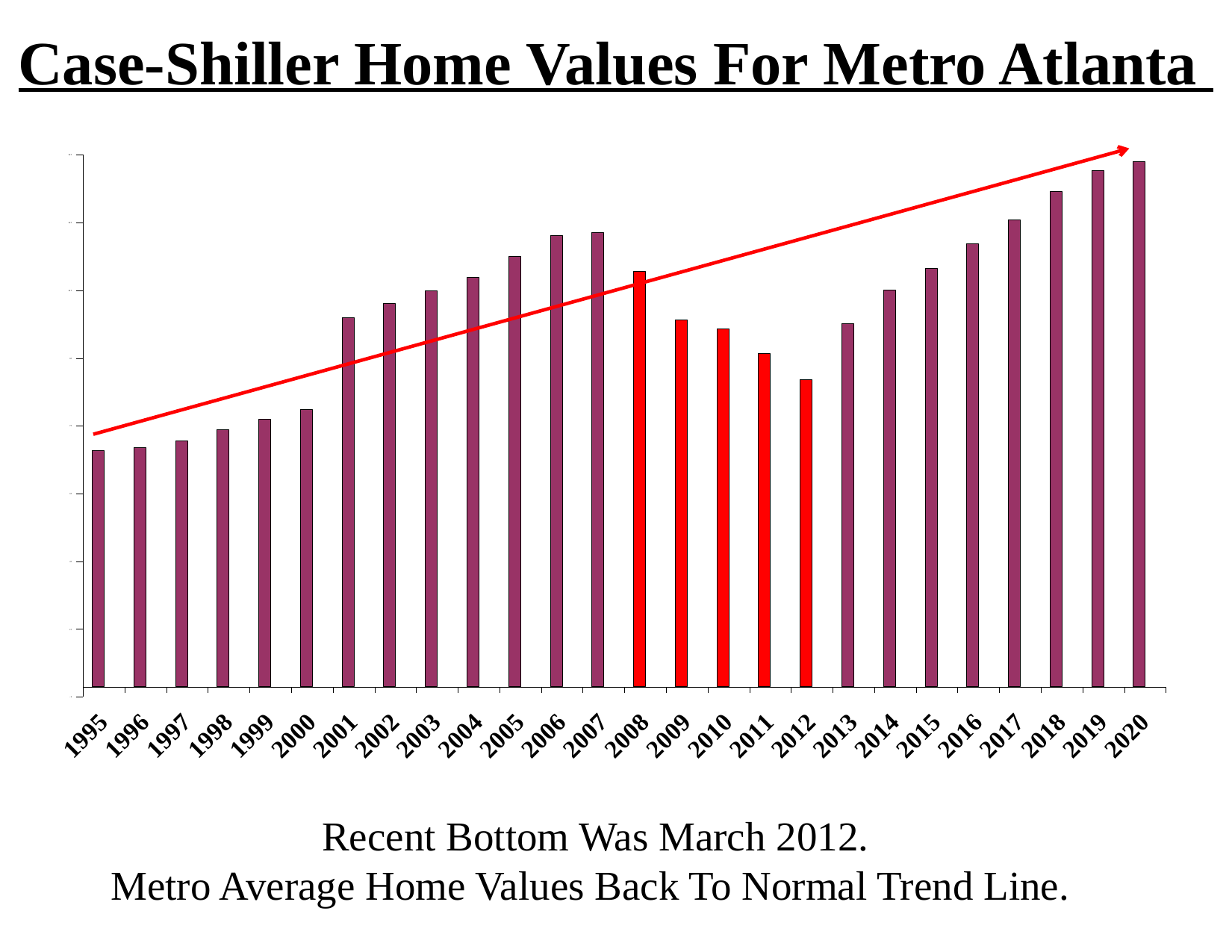
Which year has the higher value, 2007 or 2012? 2007 Which year has the highest home value on the chart? 2020 How many years (bars) are plotted on the chart? 26 What is the title of the chart on the slide? Case-Shiller Home Values For Metro Atlanta Which year has the higher value, 2000 or 2001? 2001 Do the values rise or fall from 2008 to 2012? Fall Which year has the higher value, 2006 or 2019? 2019 Which years are shown with bright red bars? 2008, 2009, 2010, 2011, 2012 Do the values rise or fall from 2012 to 2020? Rise What kind of chart is shown on the slide? Bar chart Among the years 2008 to 2012, which year has the lowest bar? 2012 Do the values rise or fall from 1995 to 2007? Rise